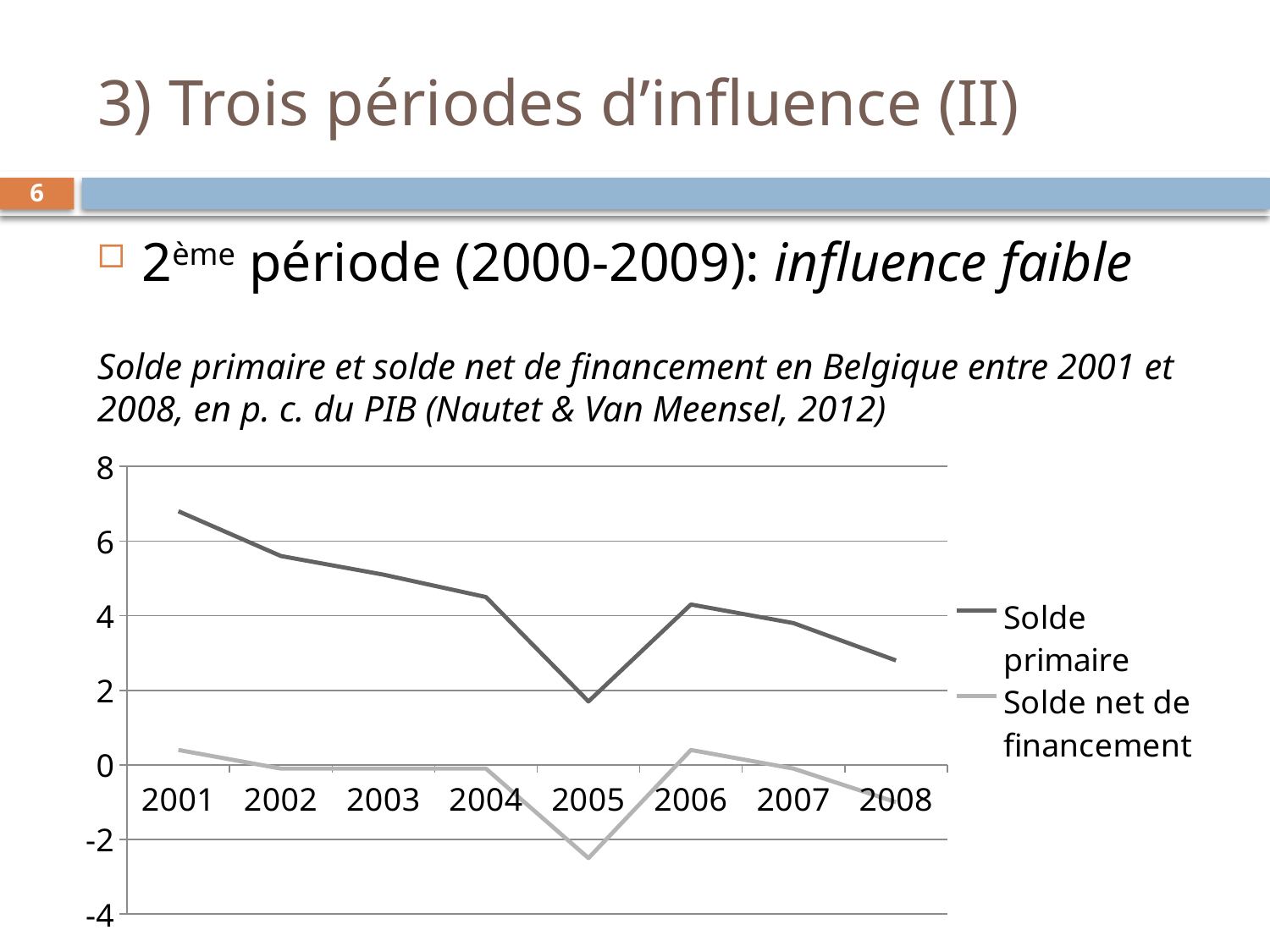
What kind of chart is shown on the slide? line chart What are the two series named in the legend? Solde primaire; Solde net de financement How many series does the legend list? 2 Is the value of Solde primaire in 2005 greater or less than 2? less Is the value of Solde net de financement in 2005 greater or less than -2? less How many years are plotted along the x axis? 8 Which series has the higher value in 2004, Solde primaire or Solde net de financement? Solde primaire In which year is the Solde primaire lowest? 2005 Is the value of Solde primaire in 2001 greater or less than 6? greater Does the Solde primaire overall rise or fall from 2001 to 2008? fall In which year is the Solde primaire highest? 2001 In which year is the Solde net de financement lowest? 2005